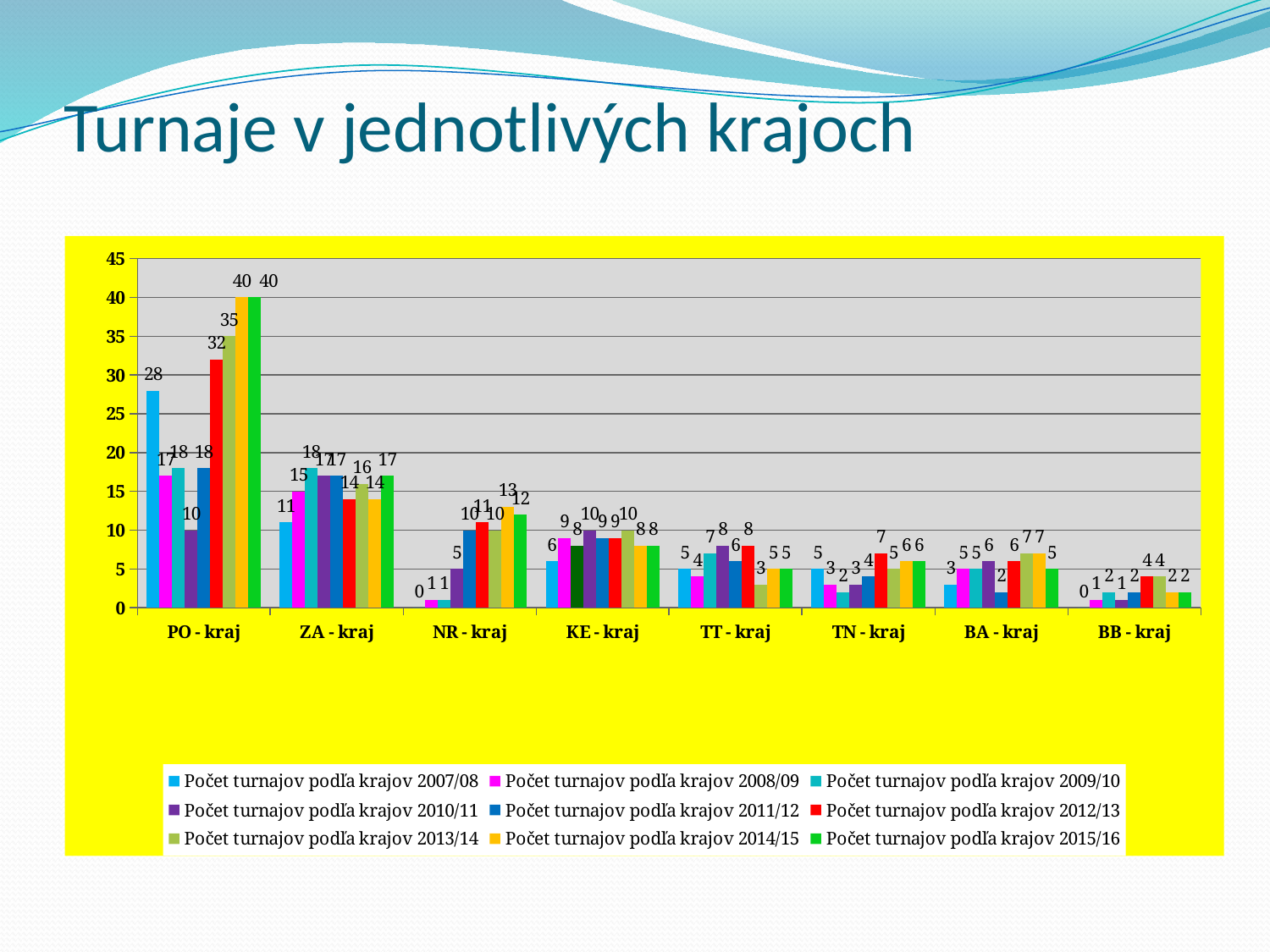
What kind of chart is shown on the slide? bar chart How many regions (categories) are shown on the x axis? 8 Which series has the lowest value for PO - kraj? Počet turnajov podľa krajov 2010/11 What is the value for PO - kraj in the series Počet turnajov podľa krajov 2007/08? 28 What is the title of the slide containing the chart? Turnaje v jednotlivých krajoch How many series does the legend list? 9 What is the value for BB - kraj in the series Počet turnajov podľa krajov 2007/08? 0 Which has the larger 2015/16 value, NR - kraj or KE - kraj? NR - kraj Which region has the highest value in the series Počet turnajov podľa krajov 2015/16? PO - kraj What is the value for NR - kraj in the series Počet turnajov podľa krajov 2014/15? 13 What is the difference between the 2014/15 values for PO - kraj and ZA - kraj? 26 What is the value for PO - kraj in the series Počet turnajov podľa krajov 2012/13? 32